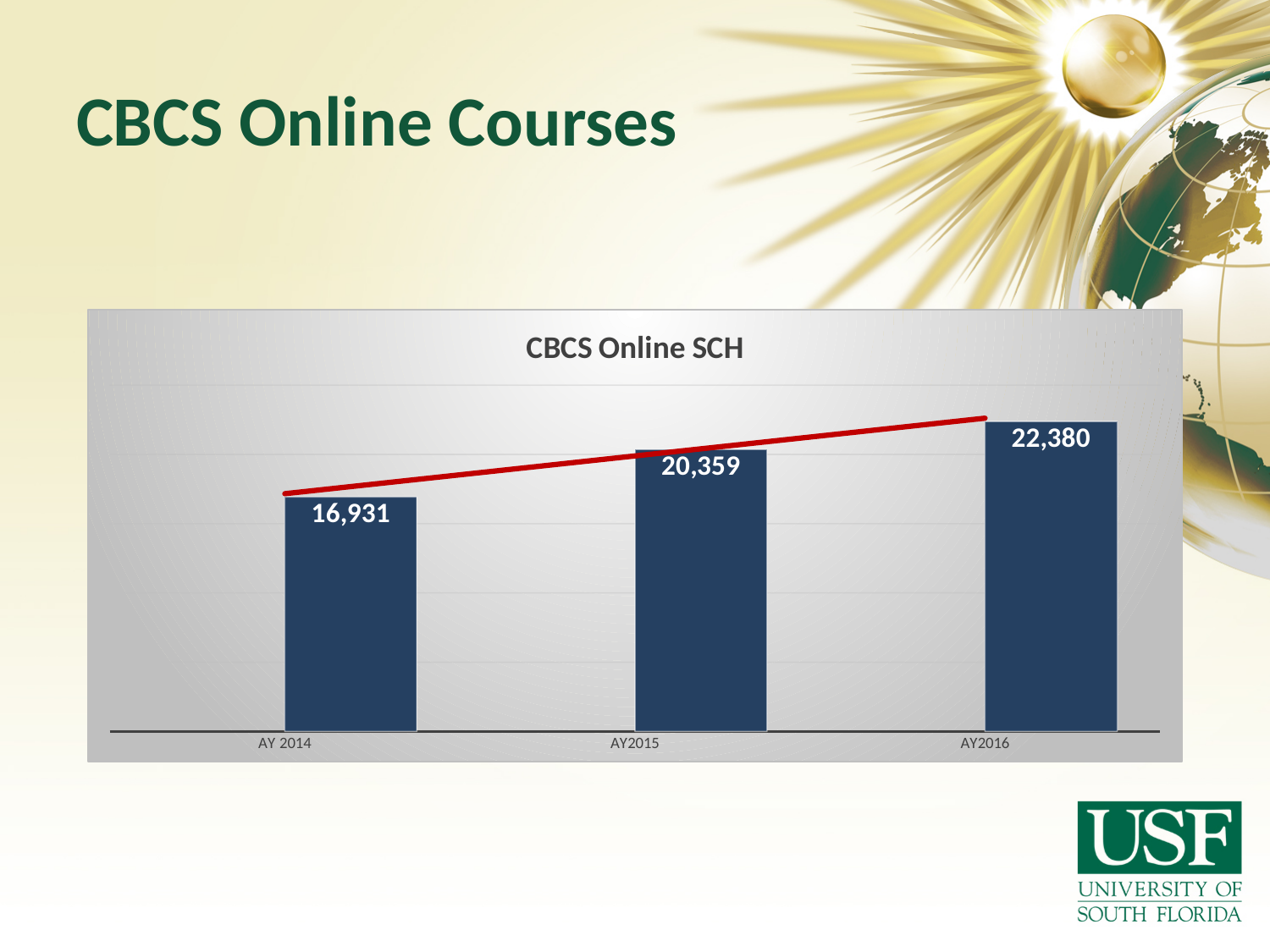
What is the difference between the values for AY2015 and AY 2014? 3,428 What is the value for AY 2014? 16,931 What is the difference between the values for AY2016 and AY 2014? 5,449 How many academic years are shown on the chart? 3 Which academic year has the highest value? AY2016 Which academic year has the lowest value? AY 2014 Do the values rise or fall from AY 2014 to AY2016? rise What is the title of the chart? CBCS Online SCH What is the value for AY2015? 20,359 What is the value for AY2016? 22,380 Which is larger, the value for AY2015 or the value for AY2016? AY2016 What kind of chart is shown on the slide? bar chart